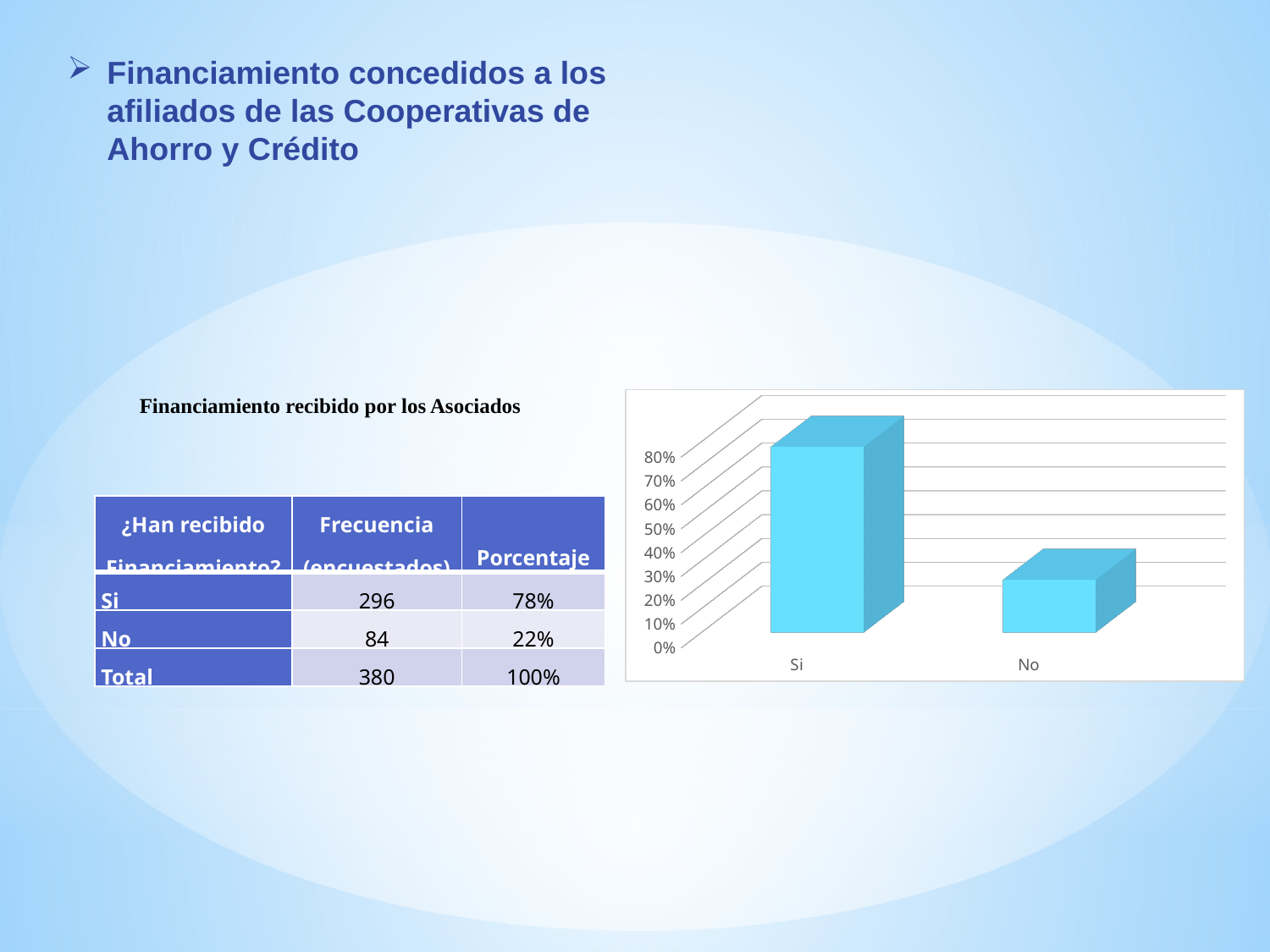
Which is larger in the bar chart, the value for Si or the value for No? Si Do the values rise or fall moving from Si to No along the x axis? fall What is the difference between the percentage for Si and the percentage for No? 56% What is the highest value labelled on the vertical axis of the bar chart? 80% What kind of chart is shown on the slide? bar chart Is the value for Si in the bar chart greater or less than 50%? greater Is the value for No in the bar chart greater or less than 30%? less Which category has the highest value in the bar chart? Si How many categories are plotted on the bar chart? 2 Which category has the lowest value in the bar chart? No What percentage does the bar for Si represent? 78% What percentage does the bar for No represent? 22%